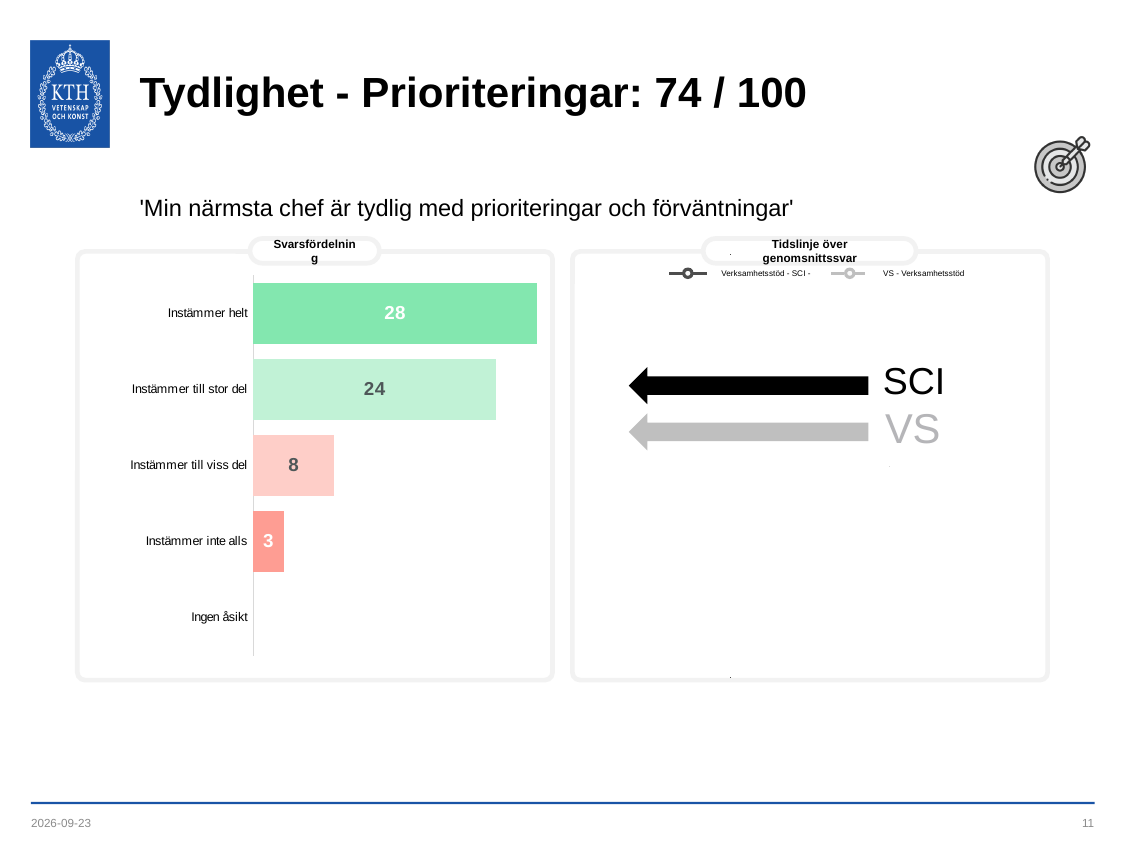
What kind of chart is the Svarsfördelning chart? Bar chart How many series does the legend of the 'Tidslinje över genomsnittssvar' chart list? 2 How many categories are listed on the axis of the Svarsfördelning chart? 5 In the Svarsfördelning chart, what is the difference between 'Instämmer till viss del' and 'Instämmer inte alls'? 5 In the Svarsfördelning chart, what is the value for 'Instämmer till viss del'? 8 In the Svarsfördelning chart, what is the difference between 'Instämmer helt' and 'Instämmer till stor del'? 4 In the Svarsfördelning chart, which category has the highest value? Instämmer helt In the Svarsfördelning chart, which is larger: 'Instämmer till stor del' or 'Instämmer till viss del'? Instämmer till stor del In the Svarsfördelning chart, what is the value for 'Instämmer till stor del'? 24 In the Svarsfördelning chart, what is the value for 'Instämmer inte alls'? 3 In the Svarsfördelning chart, what is the value for 'Instämmer helt'? 28 In the Svarsfördelning chart, which category with a labelled bar has the lowest value? Instämmer inte alls